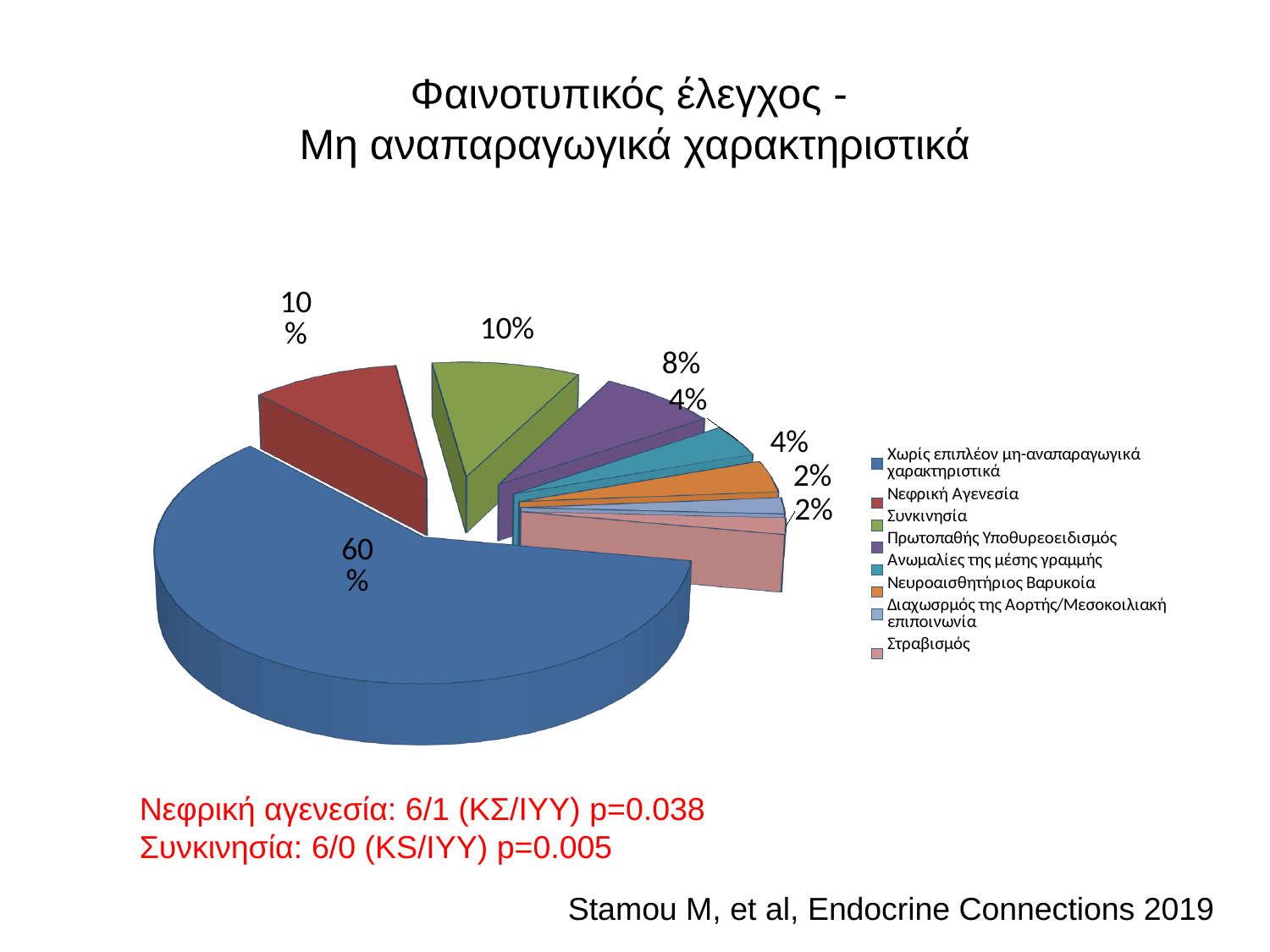
How many slices does the pie chart have? 8 What percentage is shown for 'Νεφρική Αγενεσία'? 10% What kind of chart is shown on the slide? pie chart Which category has the largest slice of the pie? Χωρίς επιπλέον μη-αναπαραγωγικά χαρακτηριστικά What is the difference in percentage points between 'Χωρίς επιπλέον μη-αναπαραγωγικά χαρακτηριστικά' and 'Συγκινησία'? 50 What percentage of the pie is labelled for 'Χωρίς επιπλέον μη-αναπαραγωγικά χαρακτηριστικά'? 60% How many entries does the legend of the pie chart list? 8 What percentage is shown for 'Πρωτοπαθής Υποθυρεοειδισμός'? 8% Which is larger, the slice for 'Πρωτοπαθής Υποθυρεοειδισμός' or the slice for 'Ανωμαλίες της μέσης γραμμής'? Πρωτοπαθής Υποθυρεοειδισμός What percentage is shown for 'Στραβισμός'? 2% What is the difference in percentage points between 'Νεφρική Αγενεσία' and 'Νευροαισθητήριος Βαρυκοΐα'? 6 What is the title of the slide containing the pie chart? Φαινοτυπικός έλεγχος - Μη αναπαραγωγικά χαρακτηριστικά